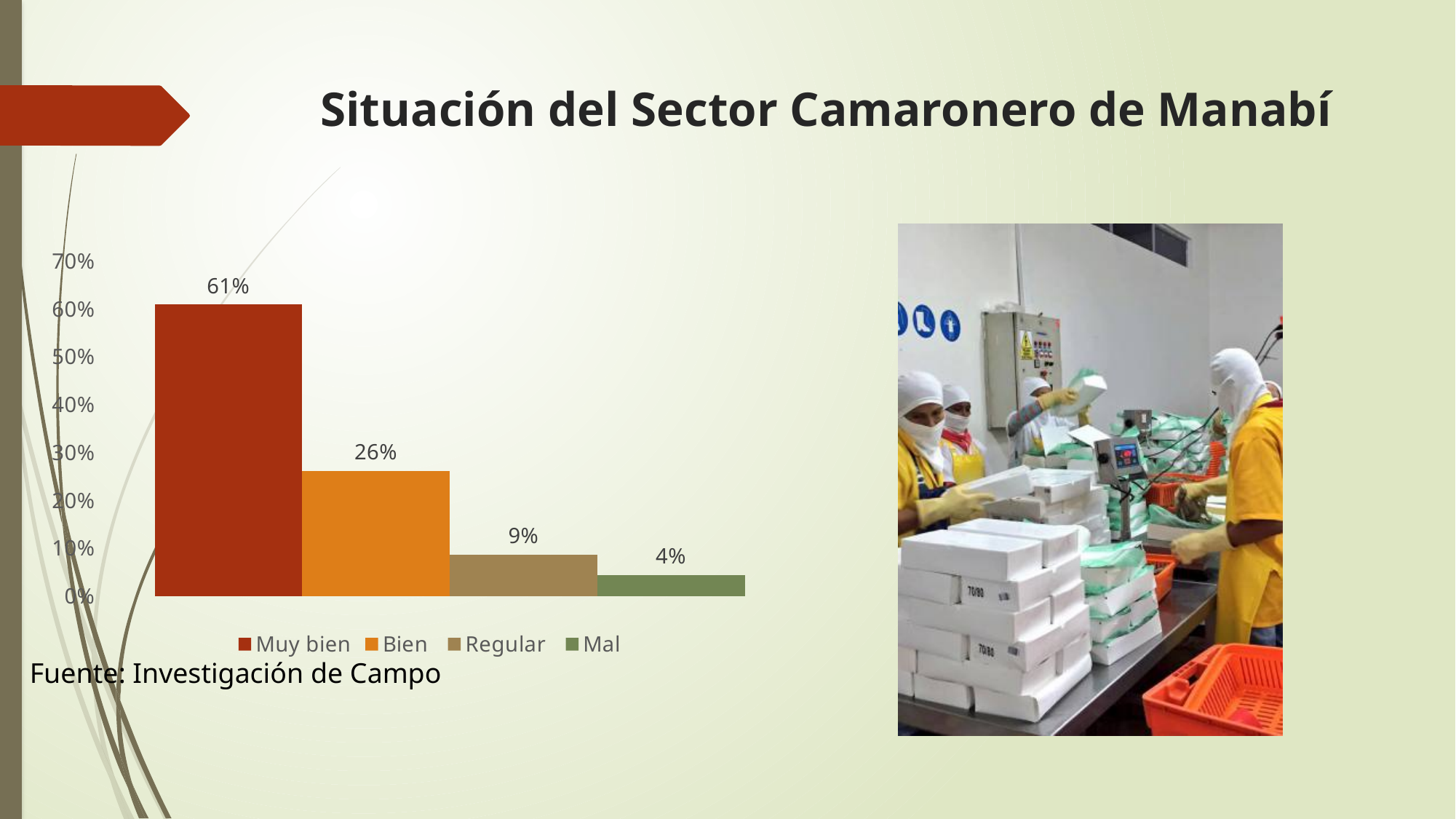
Which category has the highest value? Muy bien What is the value for Bien? 26% What is the difference between the values for Muy bien and Bien? 35% Is the value for Bien greater or less than 30%? less What is the value for Regular? 9% What kind of chart is shown on the slide? bar chart Which is larger, the value for Regular or the value for Mal? Regular How many categories are shown in the chart? 4 What is the value for Muy bien? 61% Do the values rise or fall from left to right across the bars? fall What is the value for Mal? 4% Which category has the lowest value? Mal